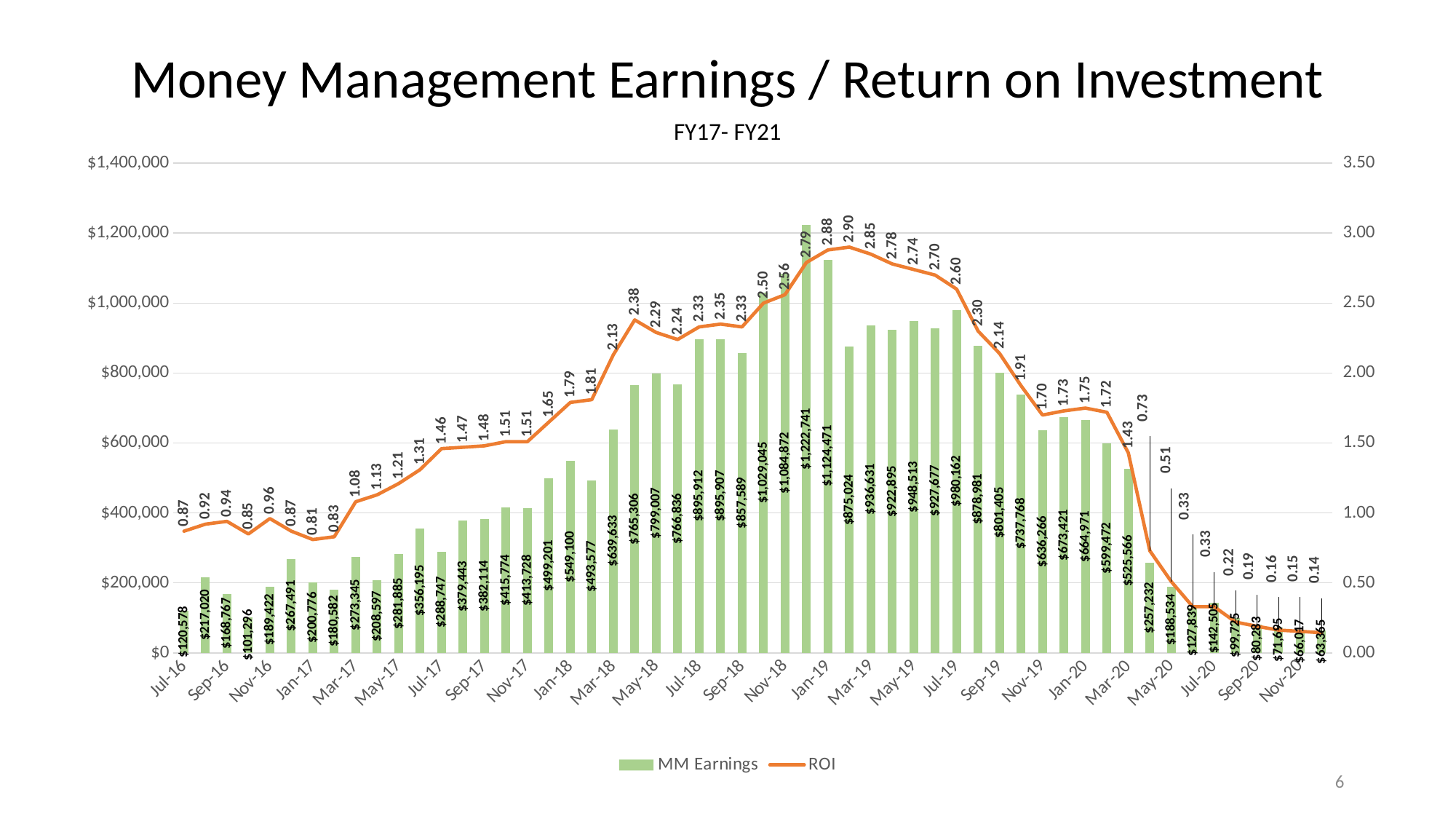
What is the lowest MM Earnings value shown on the chart? $63,365 What period does the chart subtitle cover? FY17- FY21 What is the highest ROI value shown on the chart? 2.90 What is the highest MM Earnings value shown on the chart? $1,222,741 What kind of chart is shown on the slide? Combination bar and line chart How many series does the legend list? 2 What is the ROI value for Jul-16? 0.87 What is the MM Earnings value for Jul-16? $120,578 What are the two series named in the legend? MM Earnings and ROI What is the MM Earnings value for Jan-19? $1,124,471 What is the ROI value for Jul-19? 2.60 Which is larger, the MM Earnings for Jul-16 or for Nov-20? Jul-16